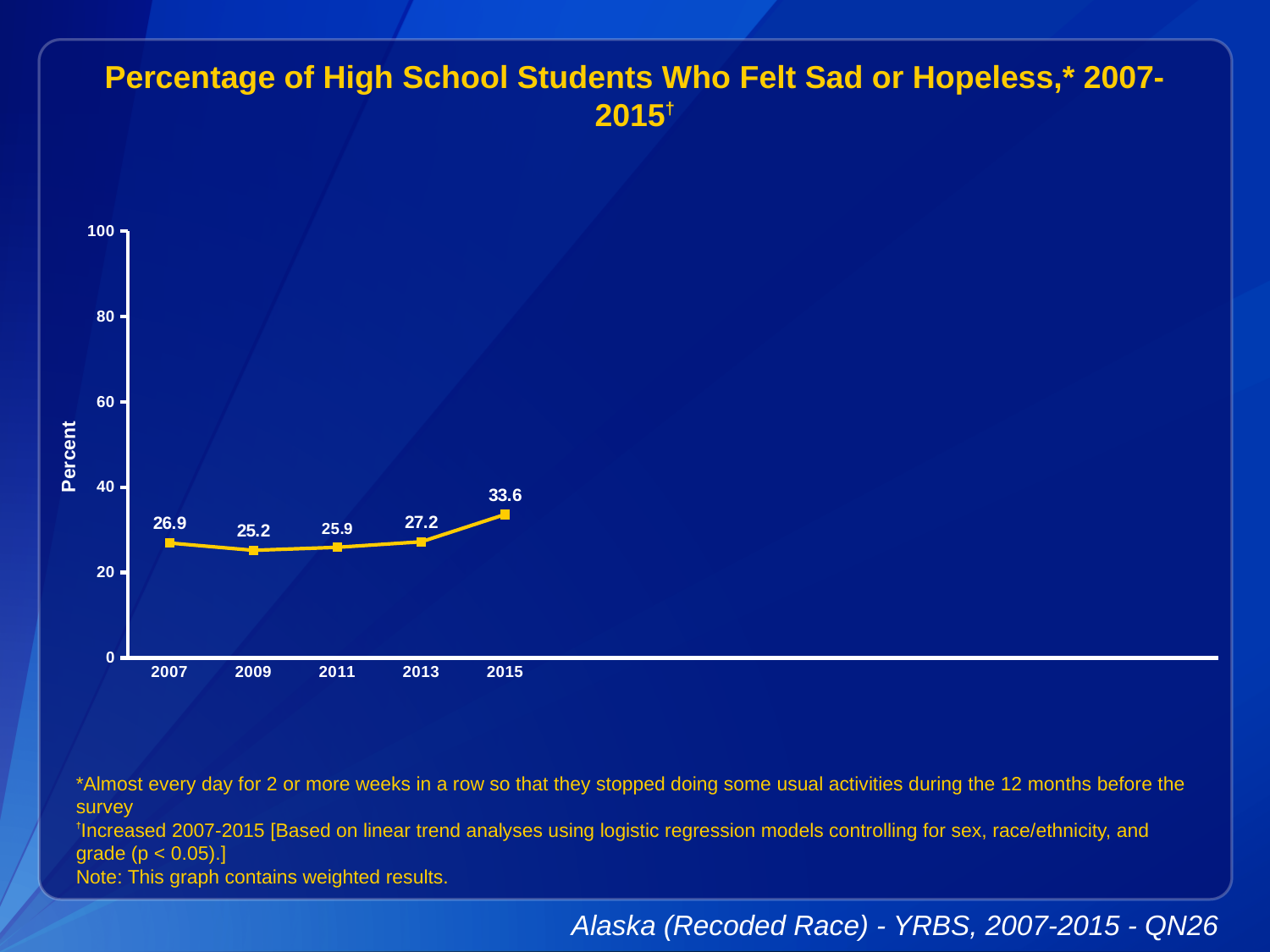
Which is larger, the value for 2013 or the value for 2009? 2013 What is the value for 2007? 26.9 What kind of chart is shown? line chart Which year has the lowest value? 2009 How many years are plotted on the chart? 5 What is the label on the y axis? Percent What is the value for 2015? 33.6 What is the difference between the values for 2015 and 2007? 6.7 Which year has the highest value? 2015 What is the value for 2011? 25.9 Do the values rise or fall from 2013 to 2015? rise Is the value for 2015 greater or less than 40? less